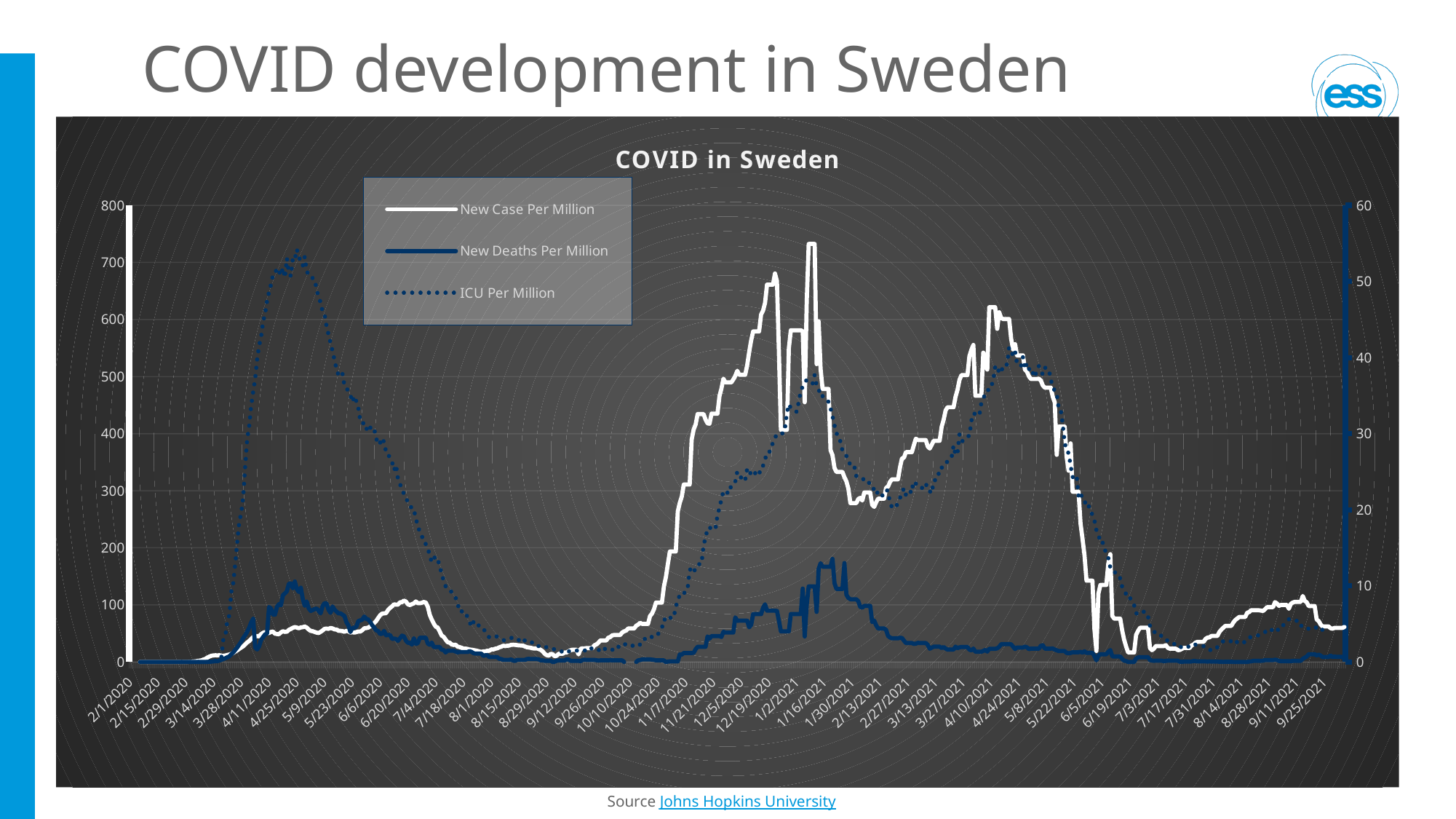
Does New Case Per Million rise or fall between 10/24/2020 and 12/19/2020? rise Is the value of ICU Per Million around 9/12/2020 greater or less than 10 on the right axis? less Is the value of New Case Per Million around 8/1/2020 greater or less than 100 on the left axis? less Is the peak value of New Case Per Million around 1/16/2021 greater or less than 700 on the left axis? greater Which series is drawn with a dotted line? ICU Per Million What is the highest tick value shown on the left vertical axis? 800 What is the title of the chart? COVID in Sweden How many series does the chart legend list? 3 What kind of chart is shown on the slide? line chart Does New Case Per Million rise or fall between 5/8/2021 and 6/19/2021? fall